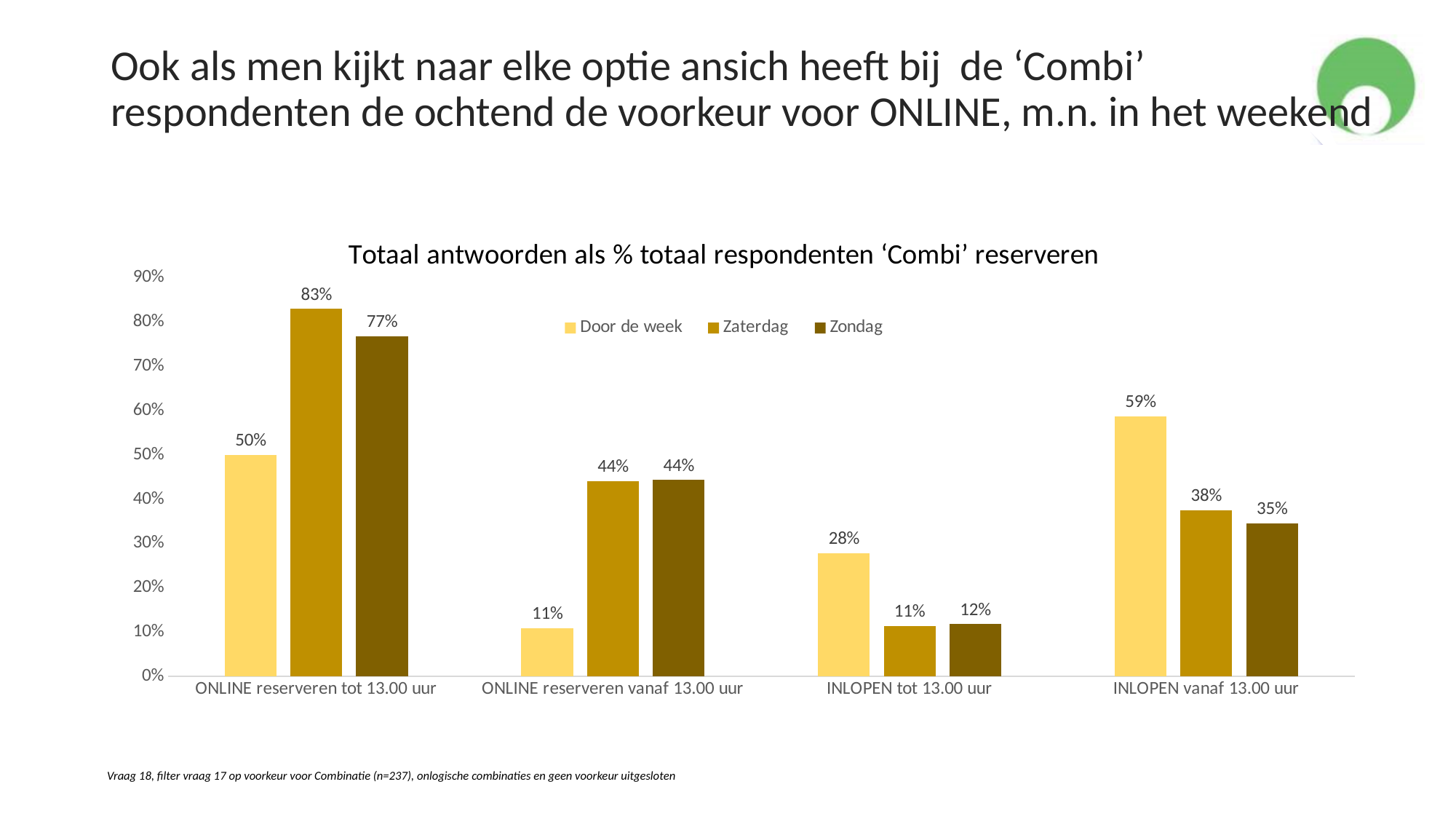
Is the value for Zondag in the 'ONLINE reserveren tot 13.00 uur' category greater or less than 70%? greater Which category has the lowest value for the Zaterdag series? INLOPEN tot 13.00 uur Which category has the highest value for the Door de week series? INLOPEN vanaf 13.00 uur What is the value for Zaterdag in the 'ONLINE reserveren tot 13.00 uur' category? 83% What kind of chart is shown on the slide? Bar chart How many series does the legend list? 3 What is the title of the chart? Totaal antwoorden als % totaal respondenten ‘Combi’ reserveren In the 'INLOPEN vanaf 13.00 uur' category, which is larger: Zaterdag or Zondag? Zaterdag How many categories are shown on the x axis? 4 What is the value for Door de week in the 'INLOPEN vanaf 13.00 uur' category? 59% What is the value for Zondag in the 'INLOPEN tot 13.00 uur' category? 12% What is the difference between the Zaterdag and Door de week values in the 'ONLINE reserveren tot 13.00 uur' category? 33%